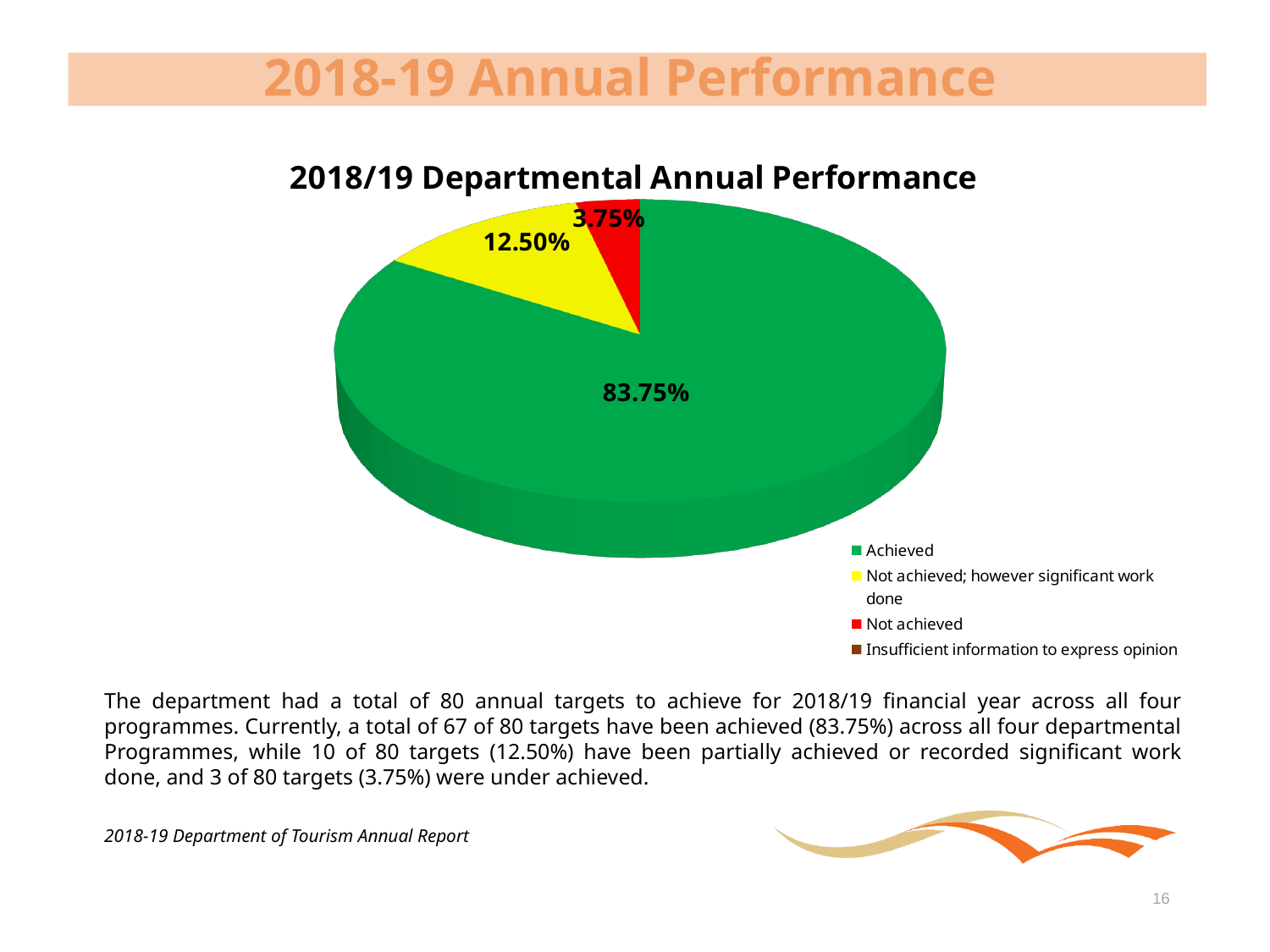
What type of chart is shown on the slide? Pie chart What is the difference in percentage points between the Achieved slice and the 'Not achieved; however significant work done' slice? 71.25% What is the title of the chart? 2018/19 Departmental Annual Performance Which category with a visible slice has the smallest share of the pie? Not achieved What percentage is shown for the 'Not achieved; however significant work done' category? 12.50% Which category has the largest share of the pie? Achieved Which is larger: the 'Not achieved; however significant work done' slice or the 'Not achieved' slice? Not achieved; however significant work done How many slices are visibly labelled with a percentage on the pie chart? 3 What colour represents the Achieved category in the pie chart? Green How many entries does the legend list? 4 What percentage of targets is shown as Achieved? 83.75% What percentage is shown for the 'Not achieved' category? 3.75%